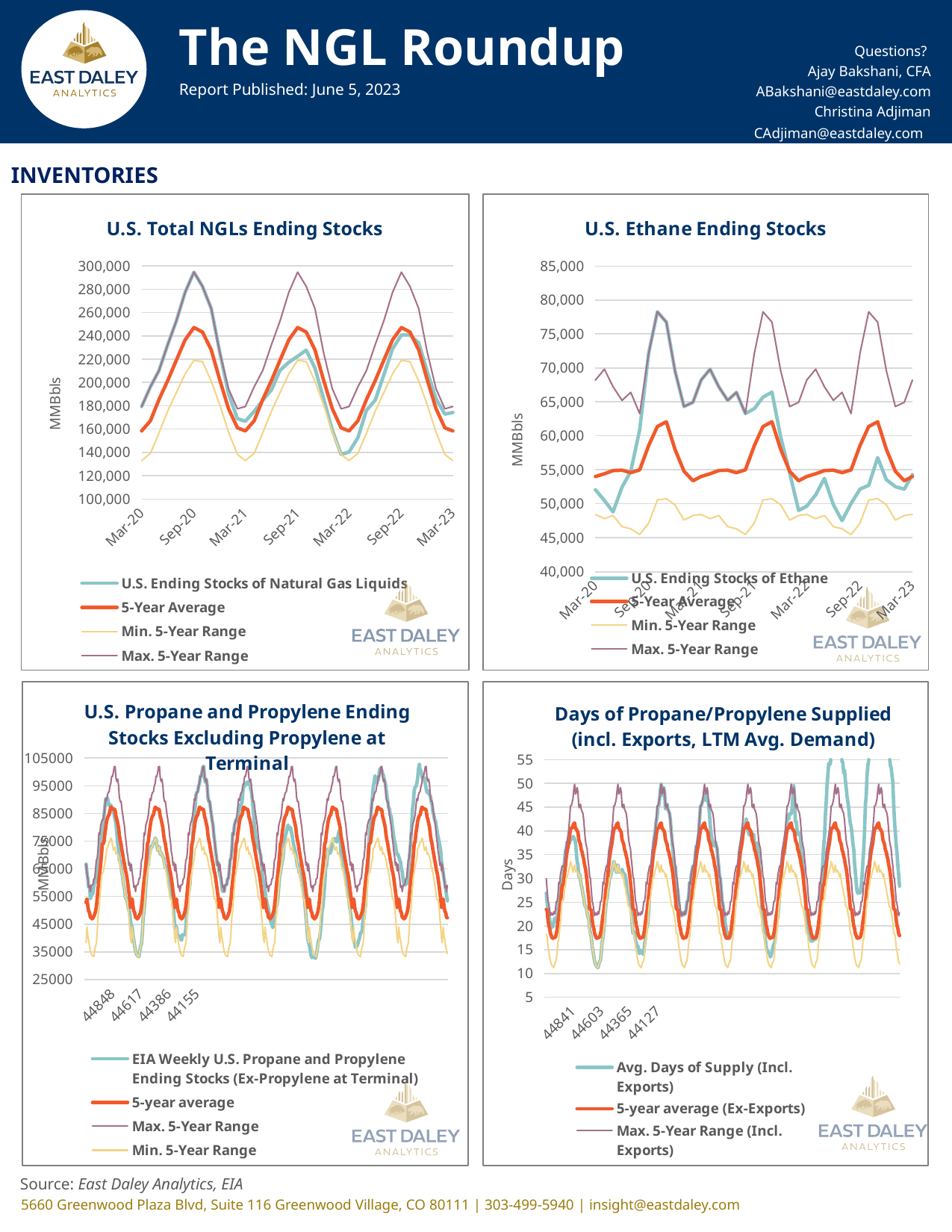
How many series does the legend of 'U.S. Total NGLs Ending Stocks' list? 4 In 'U.S. Total NGLs Ending Stocks', is the 5-Year Average value at Mar-21 greater or less than 180,000? less In 'U.S. Ethane Ending Stocks', is the U.S. Ending Stocks of Ethane value at Mar-23 greater or less than 60,000? less How many series does the legend of 'U.S. Ethane Ending Stocks' list? 4 What is the y-axis label of the 'Days of Propane/Propylene Supplied (incl. Exports, LTM Avg. Demand)' chart? Days In 'U.S. Ethane Ending Stocks', is the Max. 5-Year Range value at Mar-20 greater or less than 65,000? greater How many series does the legend of 'Days of Propane/Propylene Supplied (incl. Exports, LTM Avg. Demand)' list? 3 What kind of chart is 'U.S. Total NGLs Ending Stocks'? Line chart What kind of chart is 'Days of Propane/Propylene Supplied (incl. Exports, LTM Avg. Demand)'? Line chart